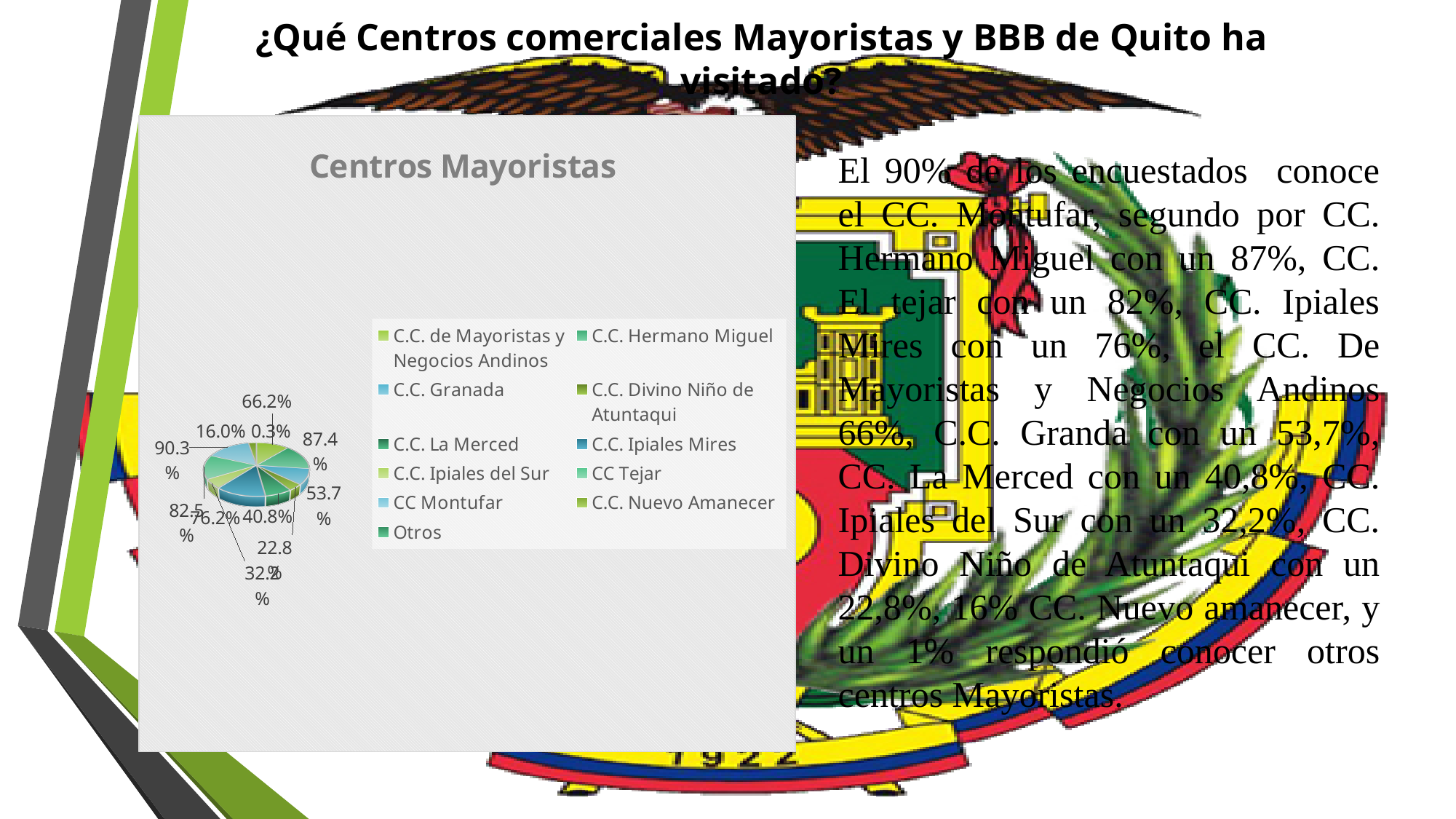
What percentage is shown for C.C. La Merced? 40.8% What percentage is shown for C.C. Nuevo Amanecer? 16.0% What percentage is shown for C.C. Granada? 53.7% What is the difference between the values for C.C. Granada (53.7%) and C.C. La Merced (40.8%)? 12.9% How many entries does the chart's legend list? 11 Which is larger, the value for C.C. Granada or the value for C.C. La Merced? C.C. Granada What is the smallest percentage label shown on the pie chart? 0.3% What is the largest percentage label shown on the pie chart? 90.3% What percentage is shown for C.C. Ipiales del Sur? 32.2% What is the title of the chart? Centros Mayoristas What percentage is shown for C.C. Divino Niño de Atuntaqui? 22.8% What kind of chart is shown on the slide? pie chart